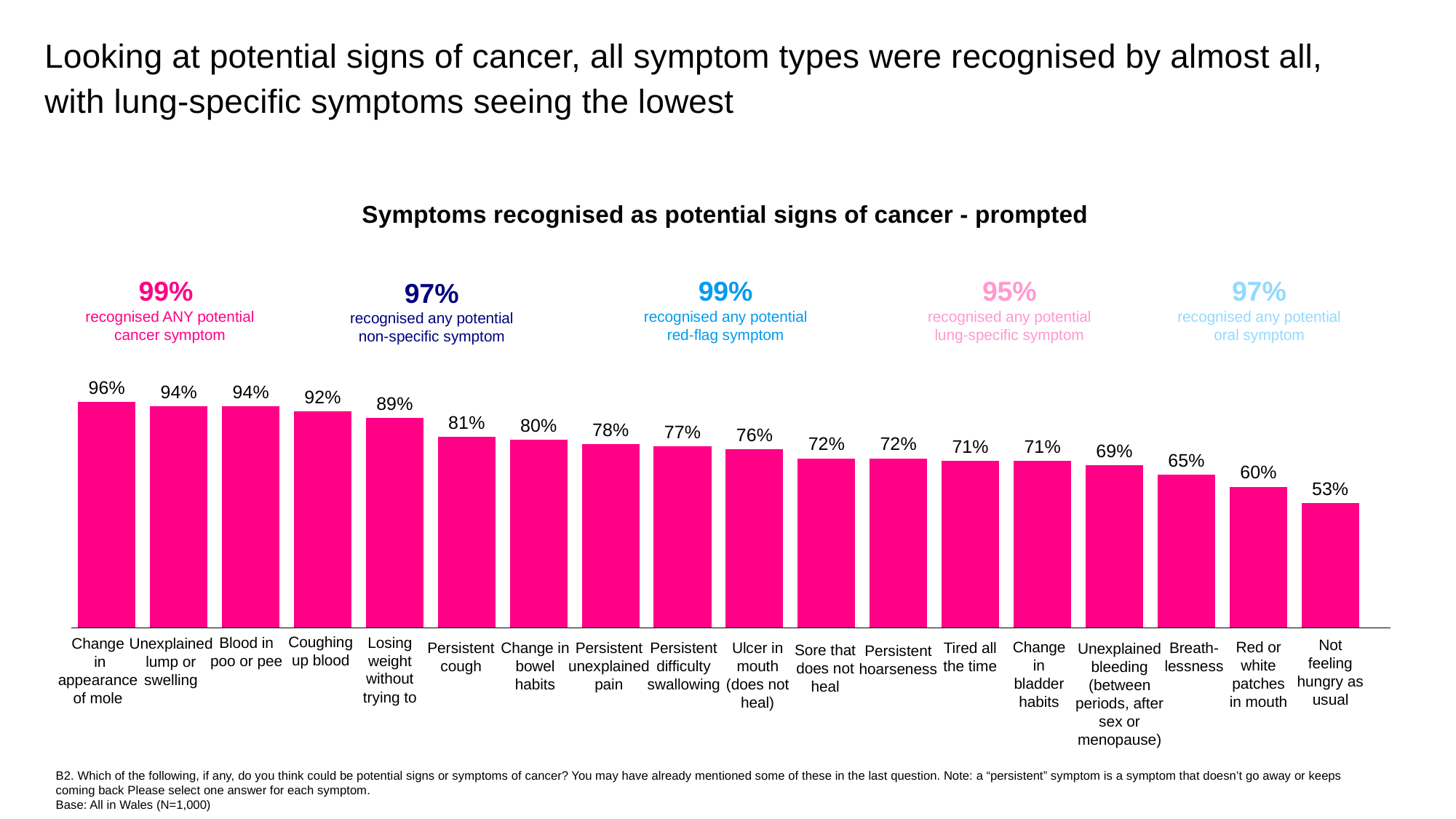
What percentage recognised any potential lung-specific symptom, according to the summary figures above the chart? 95% What is the value for 'Persistent cough'? 81% What is the title of the chart? Symptoms recognised as potential signs of cancer - prompted Do the bar values rise or fall from left to right along the x axis? Fall Which symptom has the highest recognition percentage? Change in appearance of mole Which symptom has the lowest recognition percentage? Not feeling hungry as usual What kind of chart is shown on the slide? Bar chart How many symptoms are plotted as bars in the chart? 18 What is the difference between the values for 'Coughing up blood' and 'Red or white patches in mouth'? 32% Which is larger, the value for 'Losing weight without trying to' or the value for 'Change in bowel habits'? Losing weight without trying to What percentage recognised 'Breathlessness' as a potential sign of cancer? 65% What percentage recognised 'Change in appearance of mole' as a potential sign of cancer? 96%